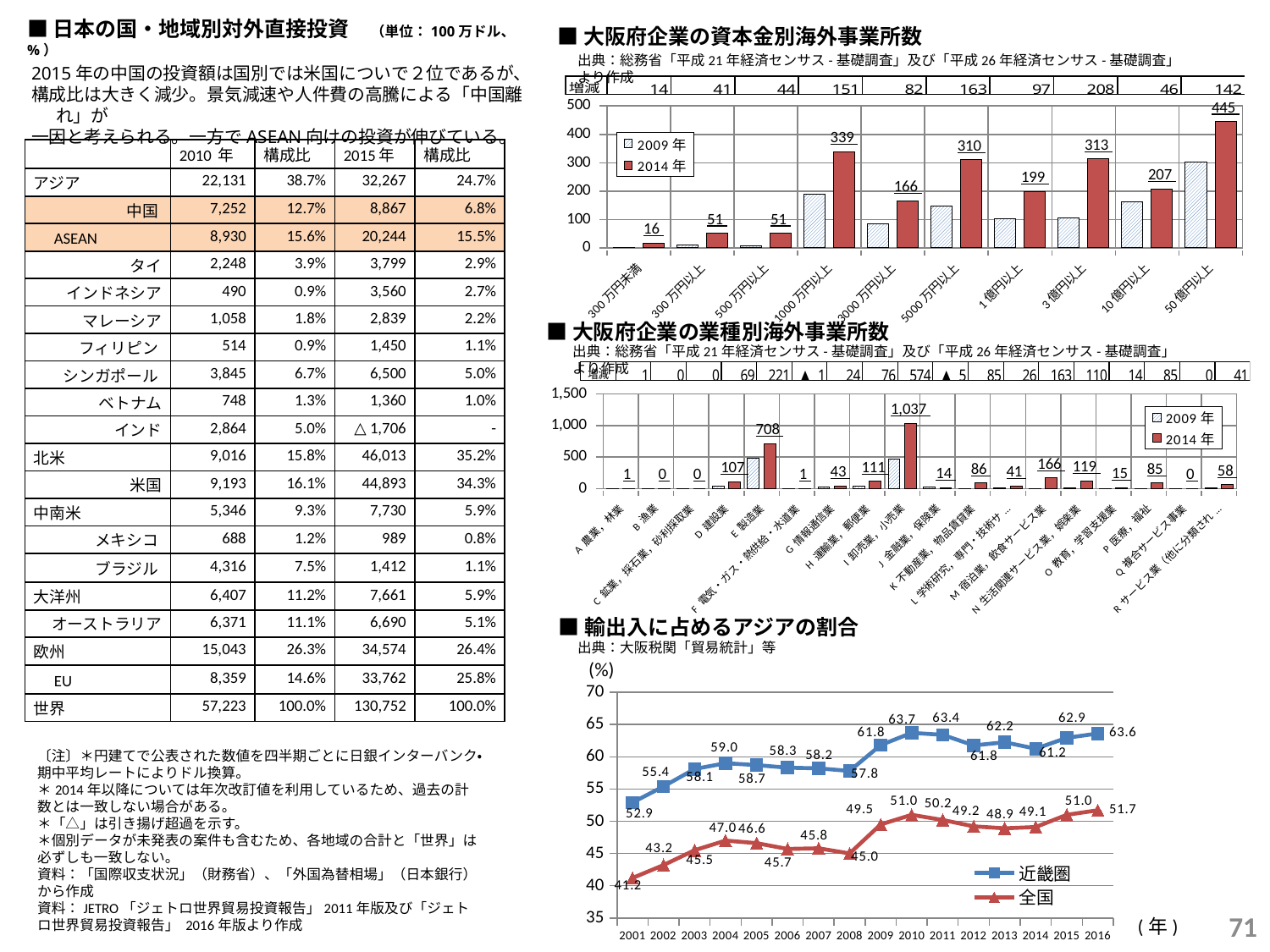
In the chart titled 輸出入に占めるアジアの割合, what is the 近畿圏 value for 2016? 63.6 In the chart titled 大阪府企業の業種別海外事業所数, what is the 2014年 value for E 製造業? 708 In the chart titled 大阪府企業の資本金別海外事業所数, what is the 2014年 value for 50億円以上? 445 In the chart titled 大阪府企業の資本金別海外事業所数, how many series does the legend list? 2 In the chart titled 大阪府企業の資本金別海外事業所数, which capital category has the highest 2014年 value? 50億円以上 In the chart titled 大阪府企業の業種別海外事業所数, which industry has the highest 2014年 value? I 卸売業，小売業 In the chart titled 輸出入に占めるアジアの割合, in which year does 近畿圏 reach its highest value? 2010 In the chart titled 輸出入に占めるアジアの割合, does the 全国 line generally rise or fall from 2001 to 2016? rise In the chart titled 大阪府企業の資本金別海外事業所数, how many capital categories are shown on the x axis? 10 In the chart titled 大阪府企業の資本金別海外事業所数, which capital category has the lowest 2014年 value? 300万円未満 In the chart titled 輸出入に占めるアジアの割合, what is the difference between the 近畿圏 and 全国 values in 2016? 11.9 In the chart titled 大阪府企業の業種別海外事業所数, what kind of chart is it? bar chart